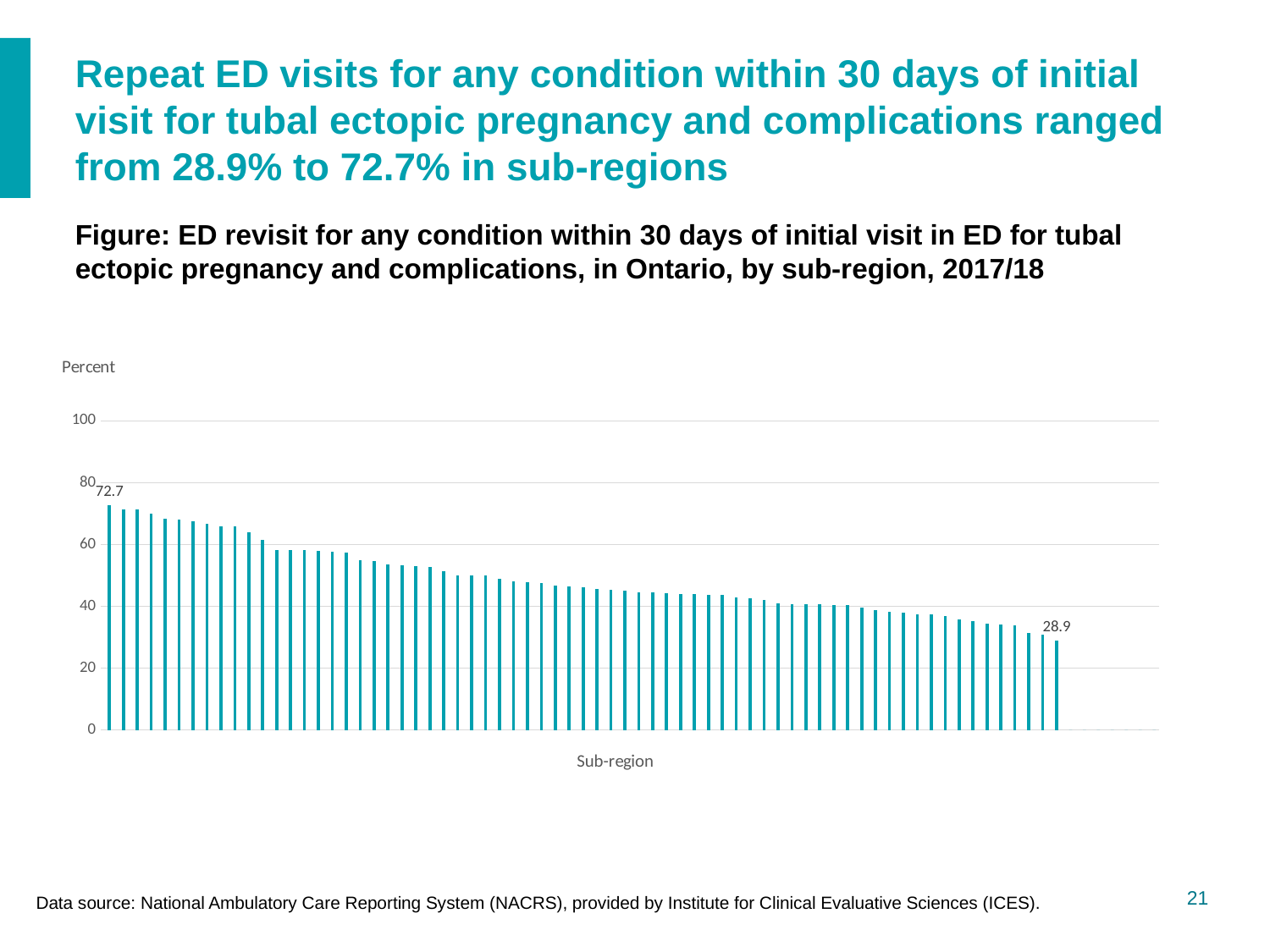
What is the highest value shown in the chart? 72.7 Which bar is larger, the leftmost bar or the rightmost bar? The leftmost bar Is the value of the leftmost bar greater or less than 60? greater Is the value of the leftmost bar greater or less than 80? less What is the label on the horizontal axis of the chart? Sub-region What kind of chart is shown on the slide? Bar chart What is the difference between the highest and lowest values labelled on the chart? 43.8 What is the lowest value shown in the chart? 28.9 Is the value of the rightmost bar greater or less than 40? less What is the label on the vertical axis of the chart? Percent Do the bar values rise or fall from left to right along the x axis? Fall